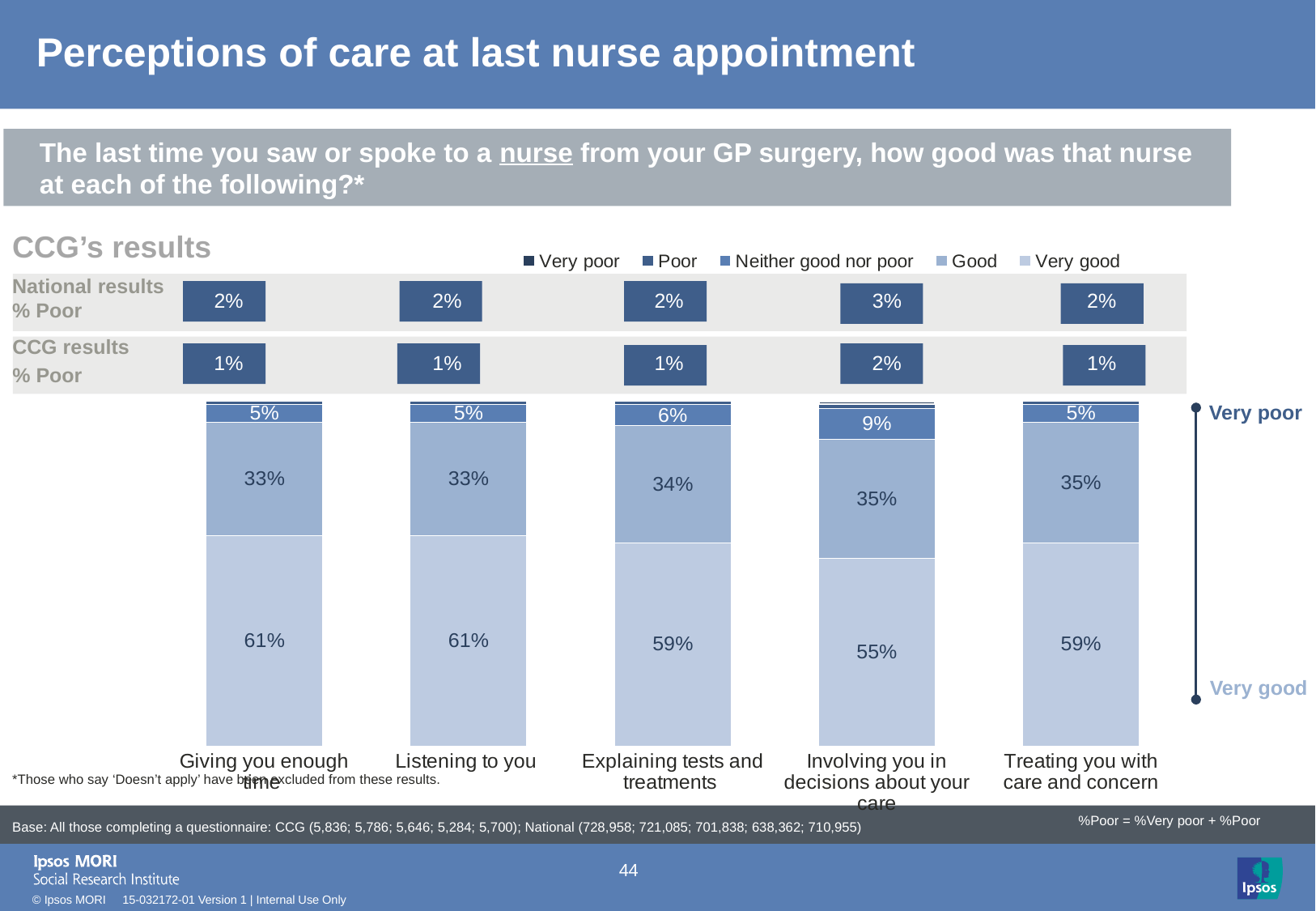
How many categories (aspects of care) are shown along the x axis of the chart? 5 What is the 'Neither good nor poor' percentage for 'Explaining tests and treatments'? 6% What percentage of CCG respondents rated 'Giving you enough time' as Very good? 61% What is the National results % Poor for 'Involving you in decisions about your care'? 3% What is the CCG results % Poor for 'Listening to you'? 1% Is the 'Very good' percentage larger for 'Treating you with care and concern' or for 'Involving you in decisions about your care'? Treating you with care and concern How many series does the chart legend list? 5 What type of chart is used to show the CCG's results? Stacked bar chart What percentage of CCG respondents rated 'Involving you in decisions about your care' as Good? 35% Which category has the highest 'Neither good nor poor' percentage? Involving you in decisions about your care What is the difference between the 'Very good' percentages for 'Listening to you' and 'Involving you in decisions about your care'? 6% Which category has the lowest 'Very good' percentage? Involving you in decisions about your care